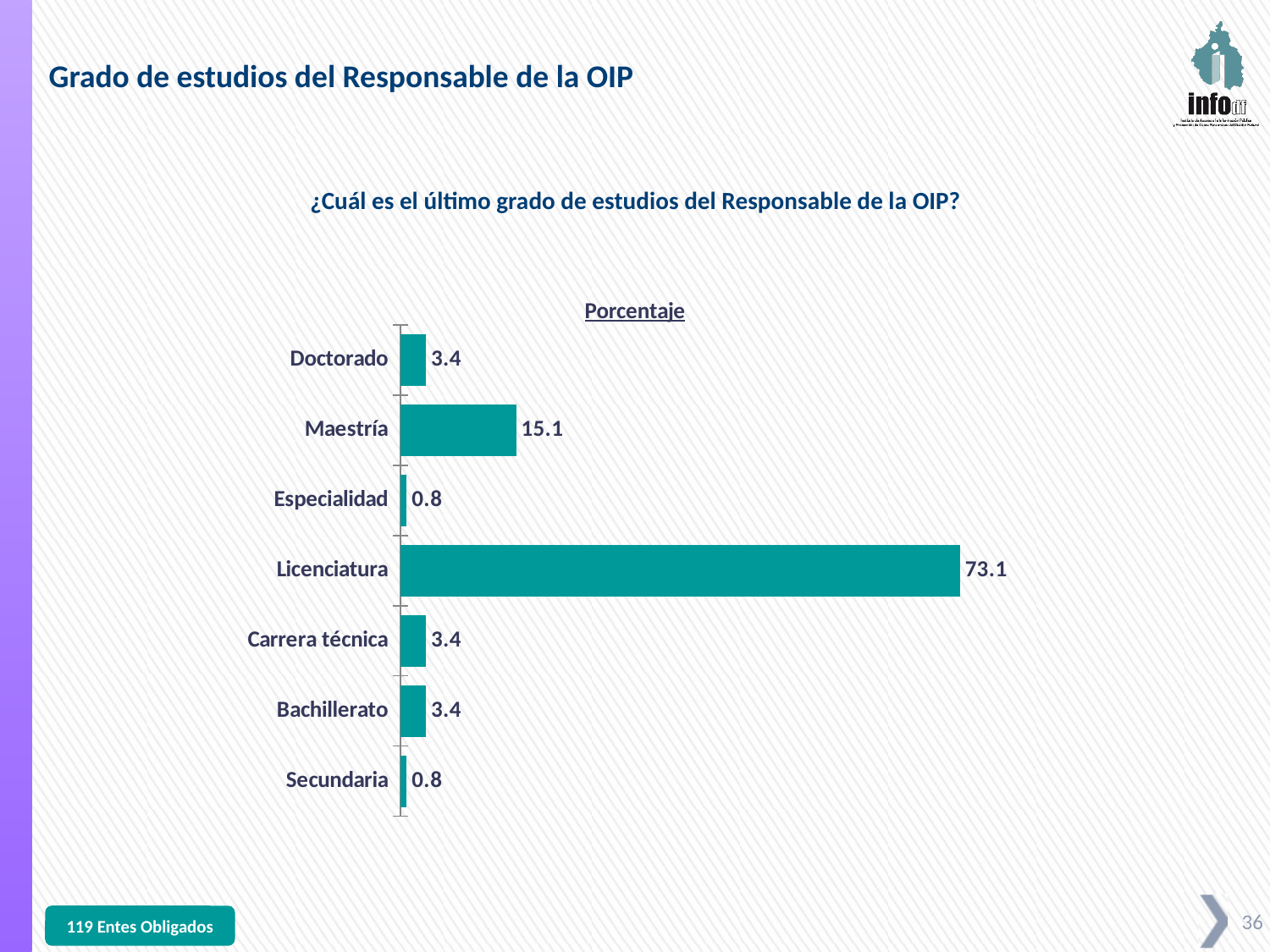
What is the value for Especialidad? 0.8 What is the value for Doctorado? 3.4 What is the value for Licenciatura? 73.1 What is the value for Secundaria? 0.8 What is the difference between the values for Maestría and Bachillerato? 11.7 How many categories are shown in the chart? 7 What is the difference between the values for Licenciatura and Maestría? 58.0 What is the value for Maestría? 15.1 Which category has the highest value? Licenciatura What kind of chart is shown on the slide? Bar chart What is the title shown above the chart? Porcentaje Which is larger, the value for Maestría or the value for Doctorado? Maestría